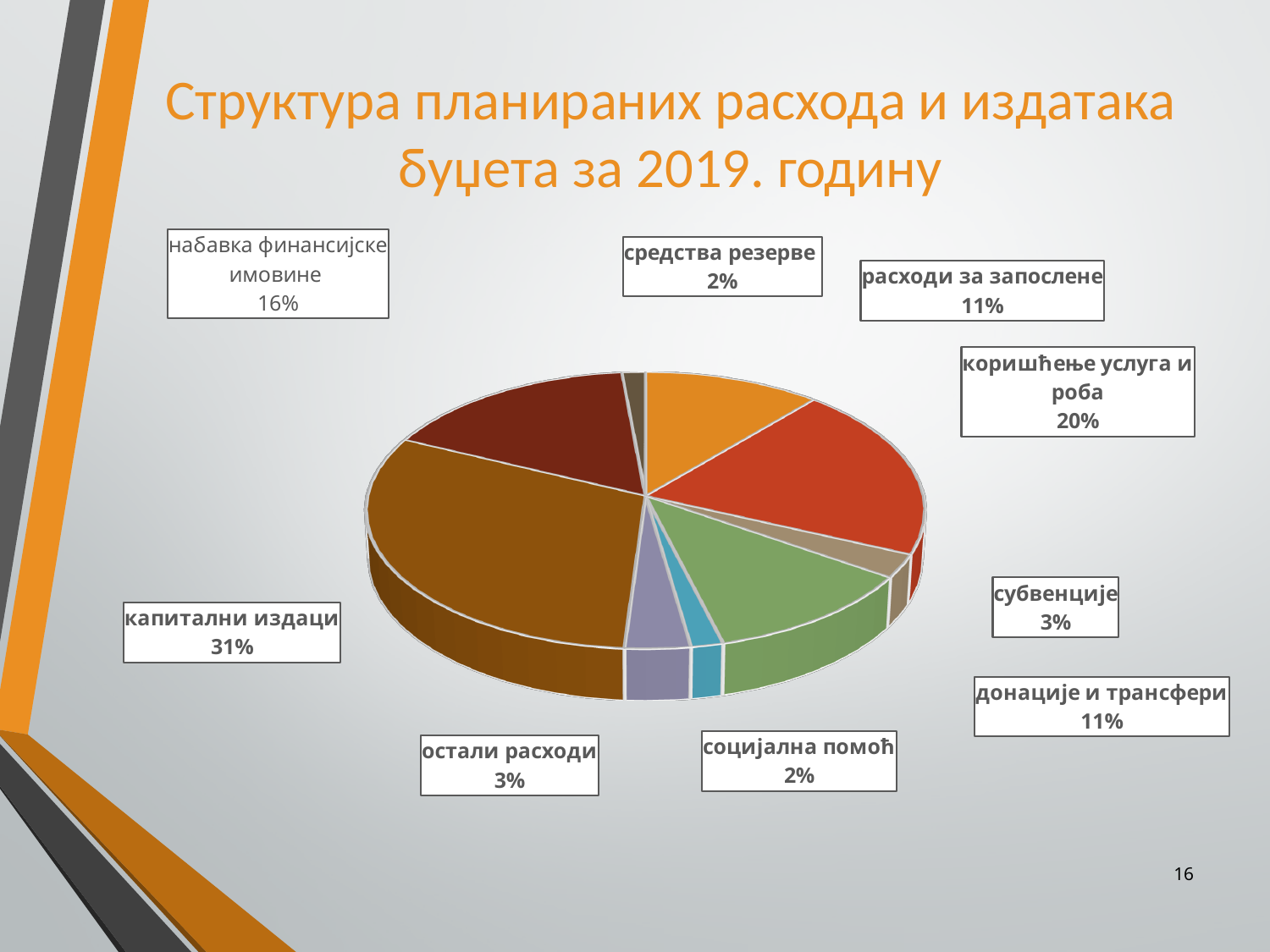
What type of chart is shown on the slide? pie chart What is the value for донације и трансфери? 11% Which two categories each have a share of 2%? средства резерве and социјална помоћ What is the difference in percentage points between капитални издаци and коришћење услуга и роба? 11 How many categories are shown in the pie chart? 9 What is the difference in percentage points between набавка финансијске имовине and остали расходи? 13 Which category has the largest share of the pie? капитални издаци What is the value shown for коришћење услуга и роба? 20% Which category is larger, расходи за запослене or субвенције? расходи за запослене What share of the pie does капитални издаци represent? 31% What is the title of the slide containing the chart? Структура планираних расхода и издатака буџета за 2019. годину What percentage is shown for набавка финансијске имовине? 16%